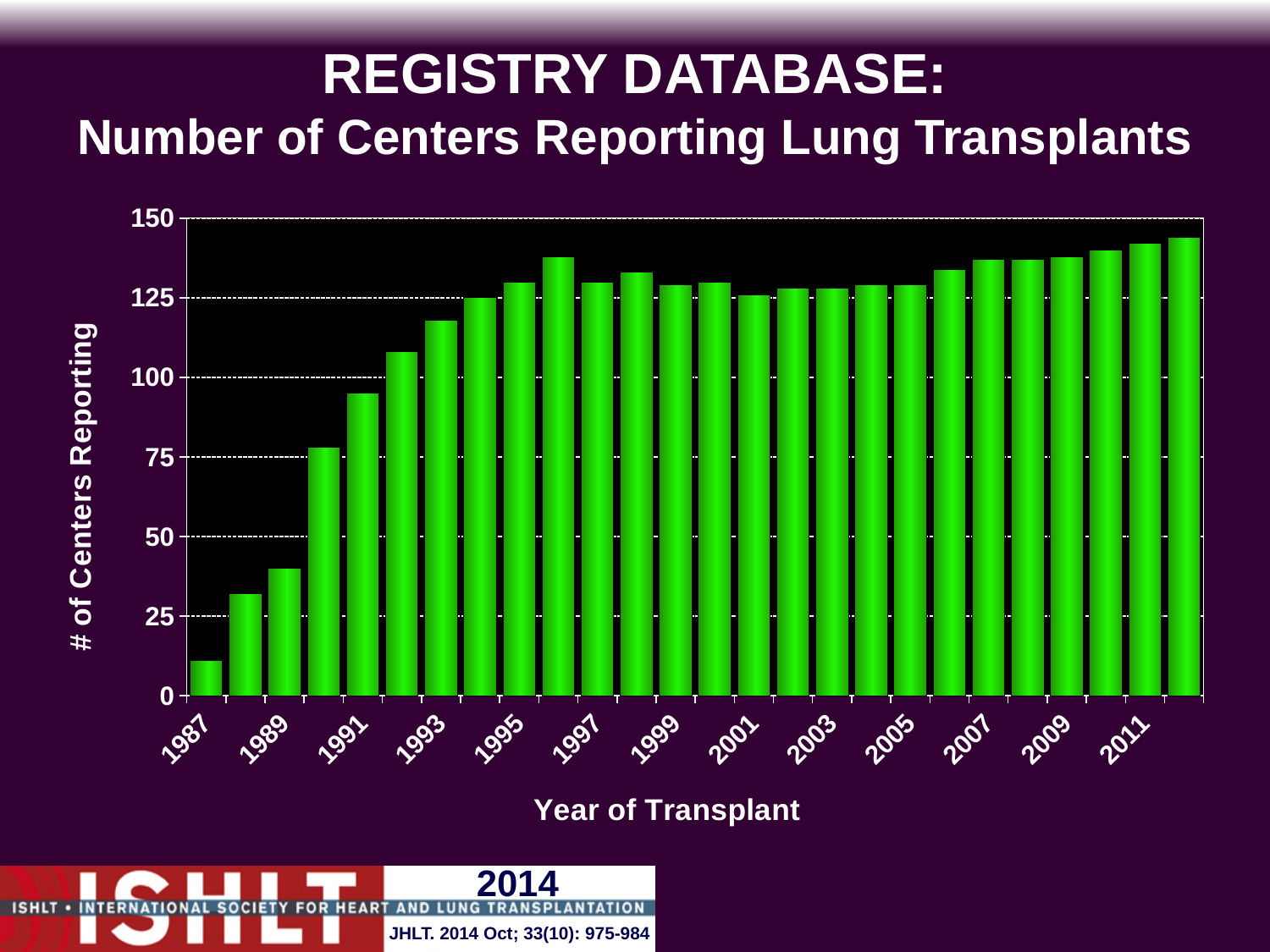
Do the values rise or fall from 1987 to 1993? rise Which year has the lowest number of centers reporting? 1987 Is the value for 2011 greater or less than 125? greater Is the value for 1989 greater or less than 50? less Which year has the larger number of centers reporting, 1989 or 1991? 1991 What is the label of the horizontal axis? Year of Transplant Is the value for 1987 greater or less than 25? less What is the label of the vertical axis? # of Centers Reporting What kind of chart is shown on the slide? bar chart Which year has the larger number of centers reporting, 1993 or 2011? 2011